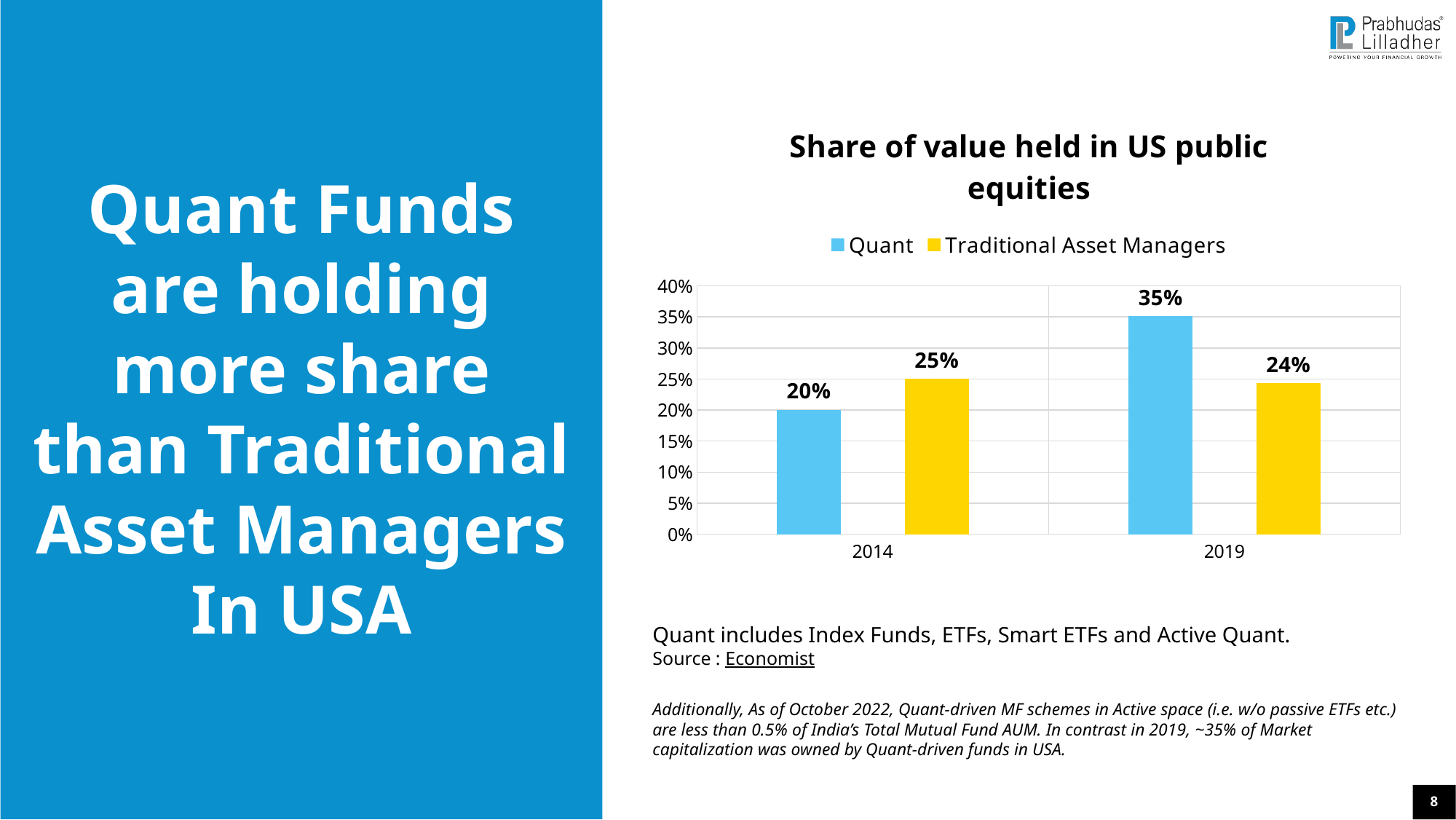
Which series has the lowest value in 2014? Quant What kind of chart is shown on the slide? Bar chart Which series has the highest value in 2019? Quant What is the value for Quant in 2019? 35% Does the Quant series rise or fall from 2014 to 2019? Rise Which is larger in 2014, Quant or Traditional Asset Managers? Traditional Asset Managers How many series does the legend list? 2 What is the value for Quant in 2014? 20% How many year categories are shown on the x axis? 2 What is the difference between the Quant values for 2019 and 2014? 15% What is the value for Traditional Asset Managers in 2019? 24% What is the value for Traditional Asset Managers in 2014? 25%